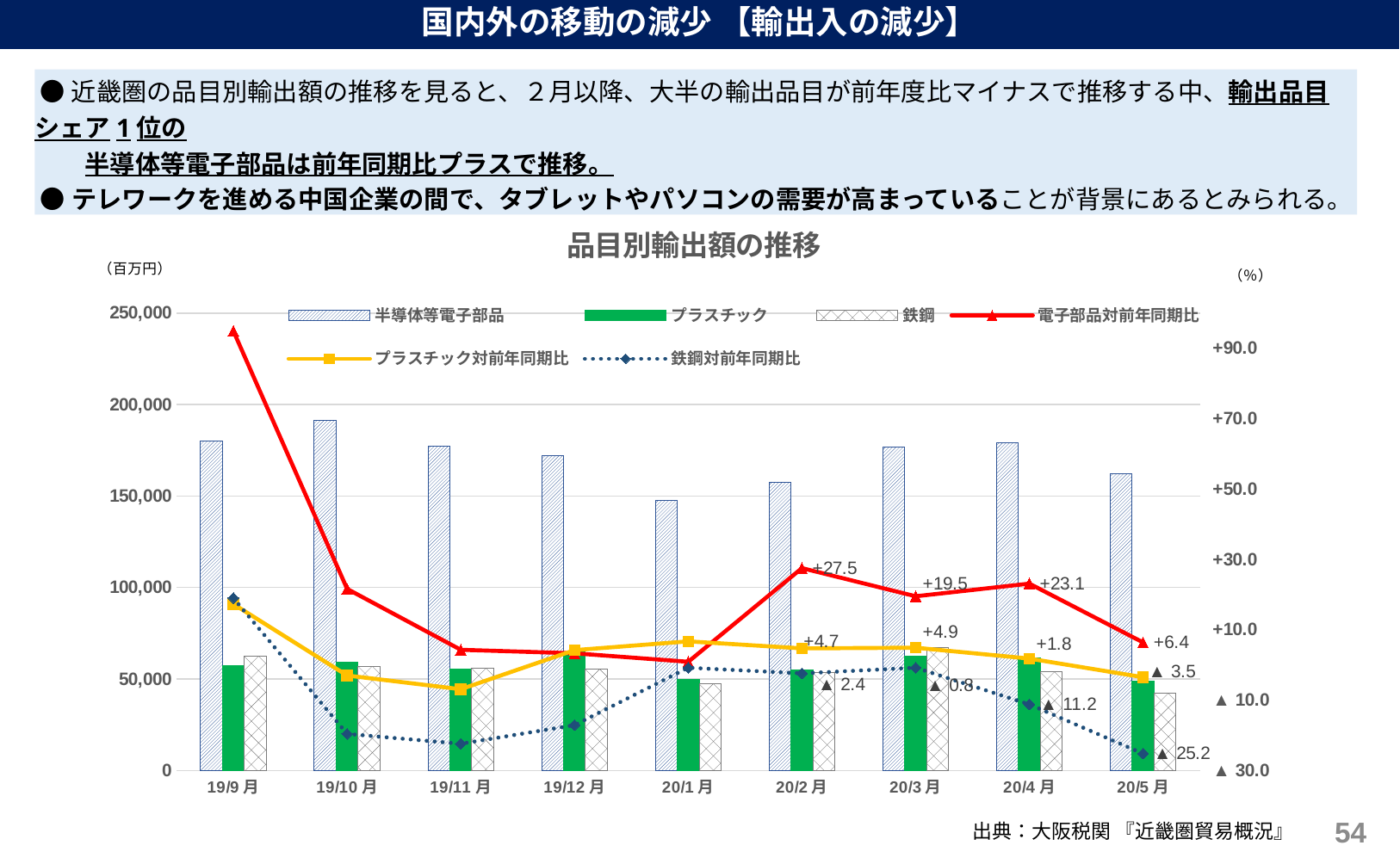
How many series does the legend of the chart list? 6 Is the 半導体等電子部品 bar for 19/10月 greater or less than 150,000? greater What is the value of 電子部品対前年同期比 for 20/2月? +27.5 What is the value of 電子部品対前年同期比 for 20/5月? +6.4 In which month is 電子部品対前年同期比 highest? 19/9月 How many months are shown on the x axis of the chart? 9 For 20/4月, which is larger: 電子部品対前年同期比 or プラスチック対前年同期比? 電子部品対前年同期比 What is the value of 鉄鋼対前年同期比 for 20/5月? ▲25.2 What kind of chart is 品目別輸出額の推移? A combined bar and line chart What is the value of プラスチック対前年同期比 for 20/3月? +4.9 By how much does 電子部品対前年同期比 fall from 20/4月 to 20/5月? 16.7 Does 鉄鋼対前年同期比 rise or fall from 20/3月 to 20/5月? fall